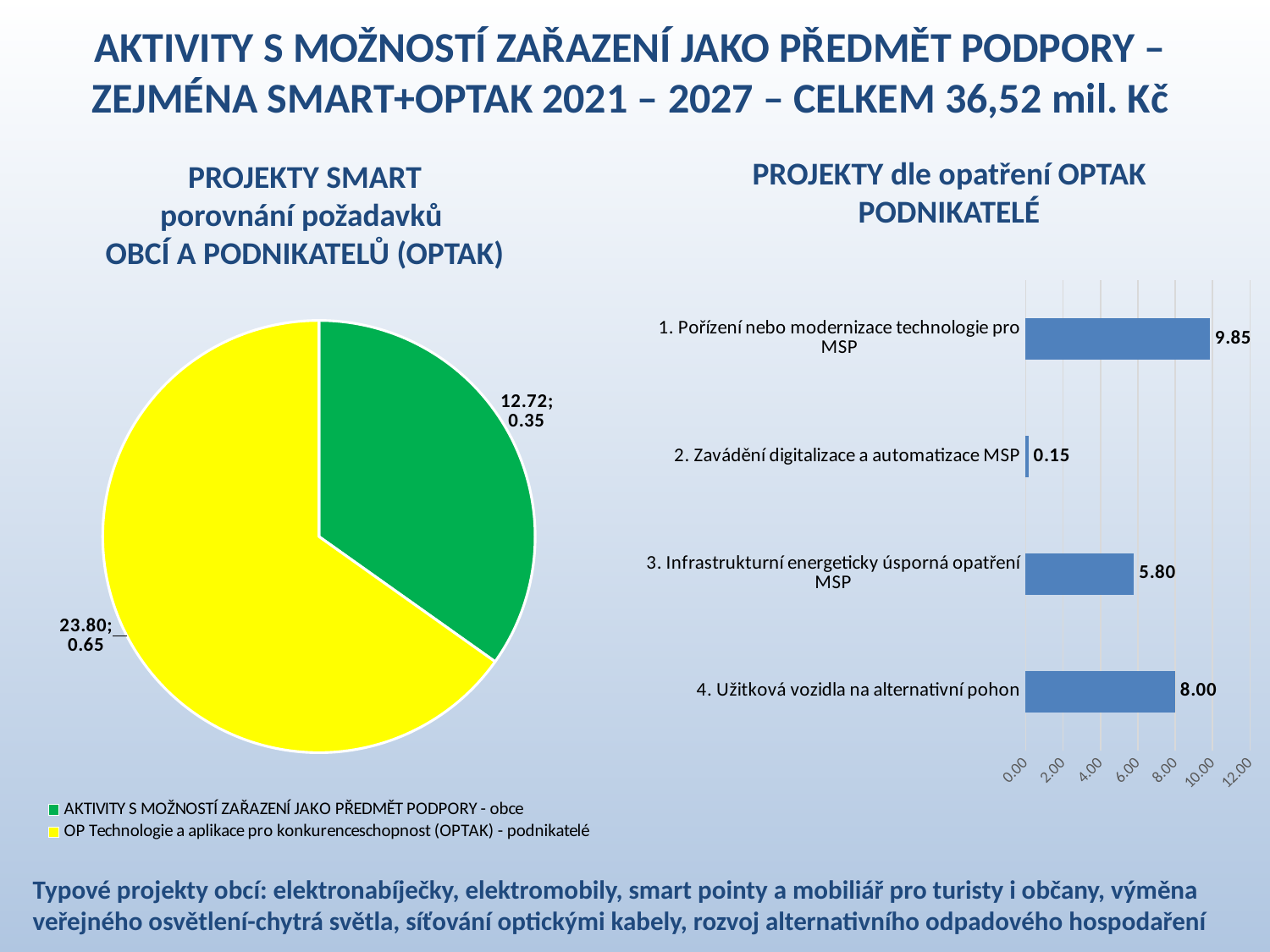
In the bar chart 'PROJEKTY dle opatření OPTAK PODNIKATELÉ', what is the value for '2. Zavádění digitalizace a automatizace MSP'? 0.15 In the bar chart 'PROJEKTY dle opatření OPTAK PODNIKATELÉ', what is the value for '4. Užitková vozidla na alternativní pohon'? 8.00 In the pie chart 'PROJEKTY SMART porovnání požadavků OBCÍ A PODNIKATELŮ (OPTAK)', what value is shown for the yellow slice 'OP Technologie a aplikace pro konkurenceschopnost (OPTAK) - podnikatelé'? 23.80; 0.65 How many categories are shown in the bar chart 'PROJEKTY dle opatření OPTAK PODNIKATELÉ'? 4 In the bar chart 'PROJEKTY dle opatření OPTAK PODNIKATELÉ', which category has the highest value? 1. Pořízení nebo modernizace technologie pro MSP How many entries does the legend of the pie chart 'PROJEKTY SMART porovnání požadavků OBCÍ A PODNIKATELŮ (OPTAK)' list? 2 In the bar chart 'PROJEKTY dle opatření OPTAK PODNIKATELÉ', what is the value for '1. Pořízení nebo modernizace technologie pro MSP'? 9.85 In the bar chart 'PROJEKTY dle opatření OPTAK PODNIKATELÉ', which is larger: the value for '3. Infrastrukturní energeticky úsporná opatření MSP' or for '4. Užitková vozidla na alternativní pohon'? 4. Užitková vozidla na alternativní pohon In the bar chart 'PROJEKTY dle opatření OPTAK PODNIKATELÉ', what is the difference between the values for '1. Pořízení nebo modernizace technologie pro MSP' and '3. Infrastrukturní energeticky úsporná opatření MSP'? 4.05 In the pie chart 'PROJEKTY SMART porovnání požadavků OBCÍ A PODNIKATELŮ (OPTAK)', which slice is larger: the green 'obce' slice or the yellow 'podnikatelé' slice? The yellow 'podnikatelé' slice In the bar chart 'PROJEKTY dle opatření OPTAK PODNIKATELÉ', which category has the lowest value? 2. Zavádění digitalizace a automatizace MSP What kind of chart is the chart on the right side of the slide, 'PROJEKTY dle opatření OPTAK PODNIKATELÉ'? Bar chart